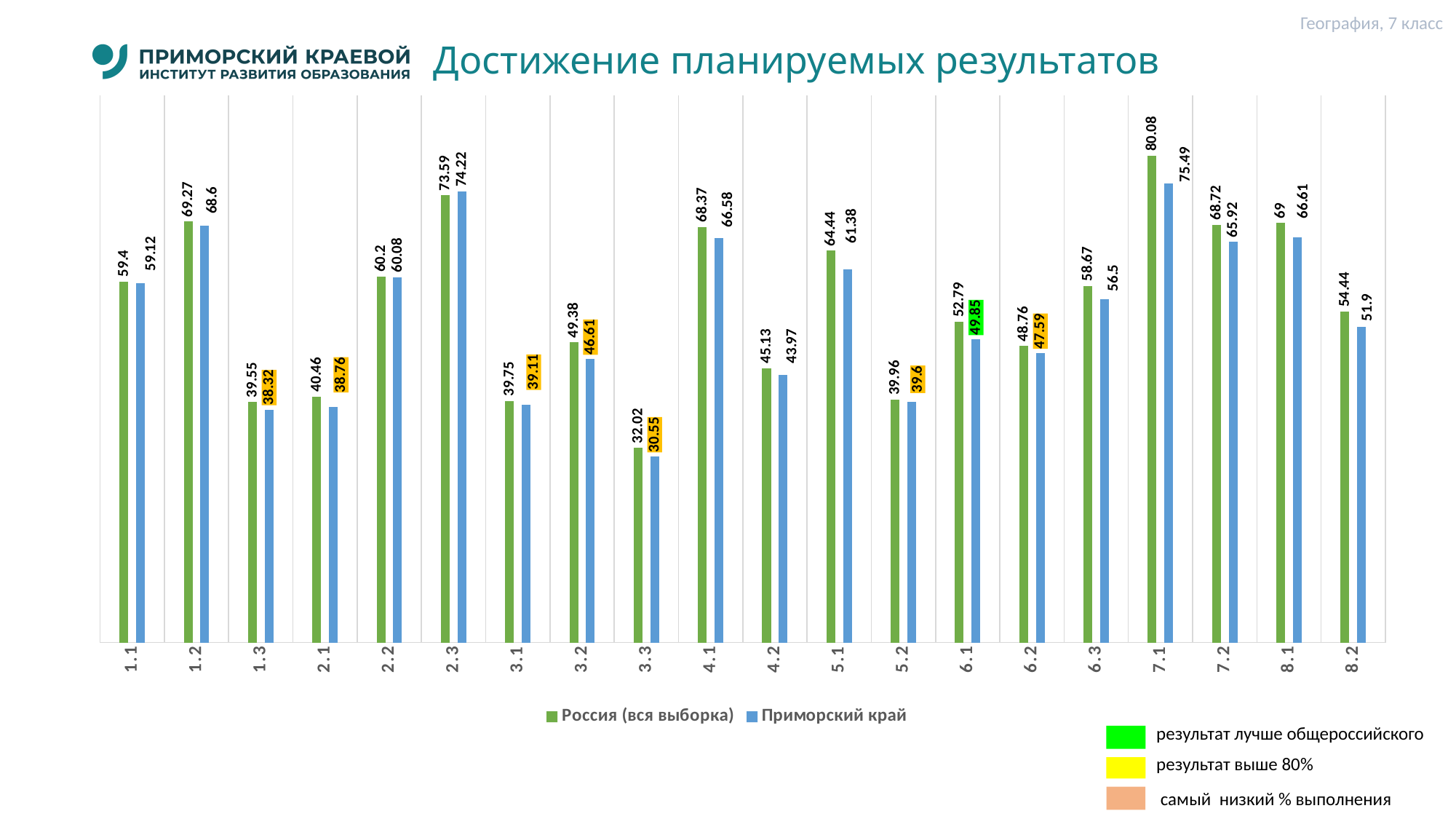
What is the title of the chart on the slide? Достижение планируемых результатов What is the value for Россия (вся выборка) in category 3.3? 32.02 What type of chart is shown on the slide? bar chart What is the value for Приморский край in category 7.1? 75.49 What is the value for Приморский край in category 2.3? 74.22 What is the difference between the Россия (вся выборка) and Приморский край values in category 7.1? 4.59 Which category has the lowest value for Приморский край? 3.3 Which category has the highest value for Россия (вся выборка)? 7.1 In category 2.3, which series has the larger value: Россия (вся выборка) or Приморский край? Приморский край How many categories are shown along the x axis of the chart? 20 How many series does the chart legend list? 2 In category 5.1, which series has the larger value: Россия (вся выборка) or Приморский край? Россия (вся выборка)